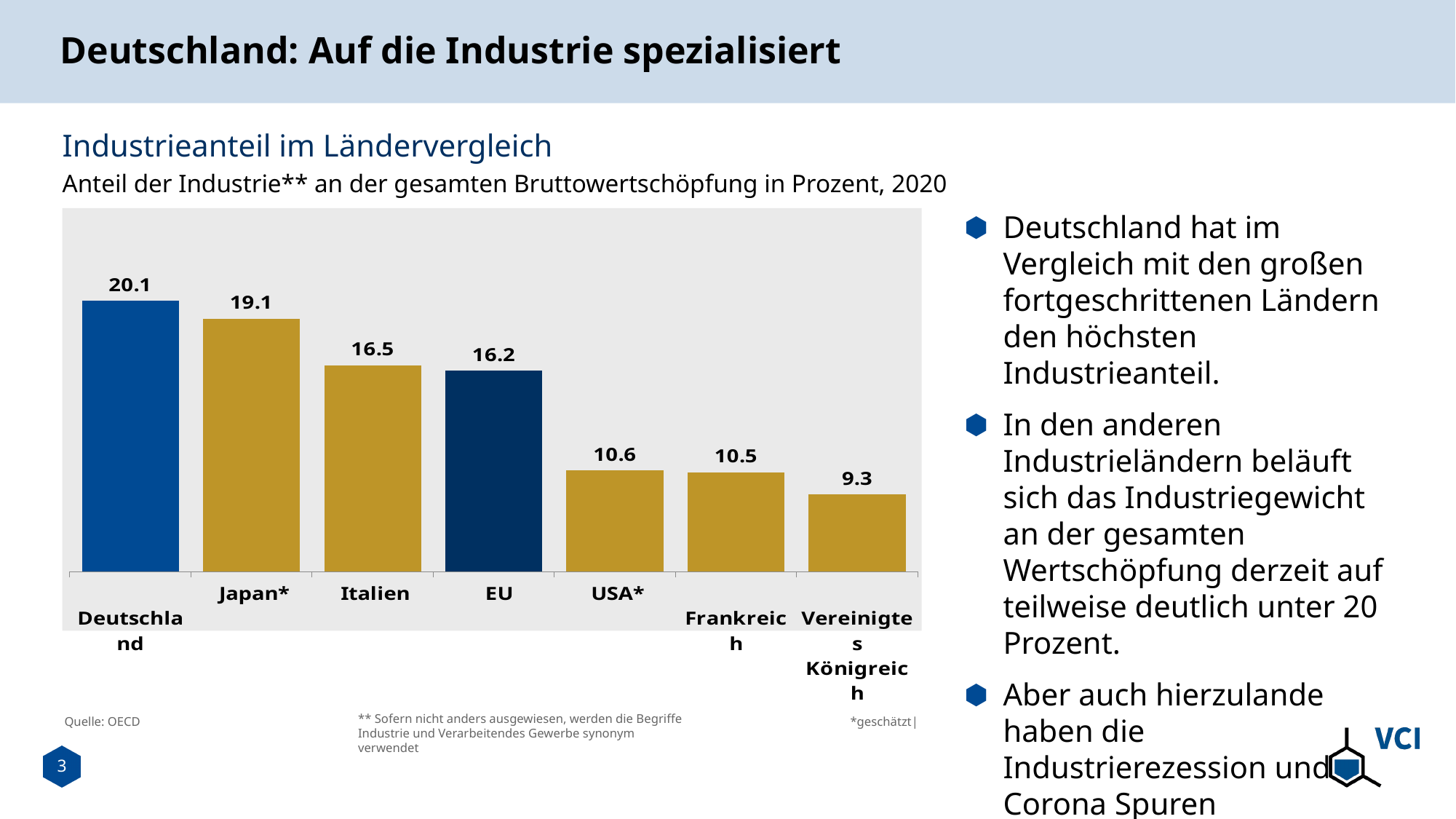
Which category has the highest value? Deutschland What is the value for Italien? 16.5 What kind of chart is shown on the slide? Bar chart What is the value for the EU? 16.2 What is the title of the chart? Industrieanteil im Ländervergleich What is the value for Deutschland? 20.1 Which category has the lowest value? Vereinigtes Königreich How many categories are shown in the chart? 7 Which is larger, the value for USA* or the value for Frankreich? USA* What is the difference between the values for Deutschland and Japan*? 1.0 What is the value for Vereinigtes Königreich? 9.3 What is the value for Japan*? 19.1